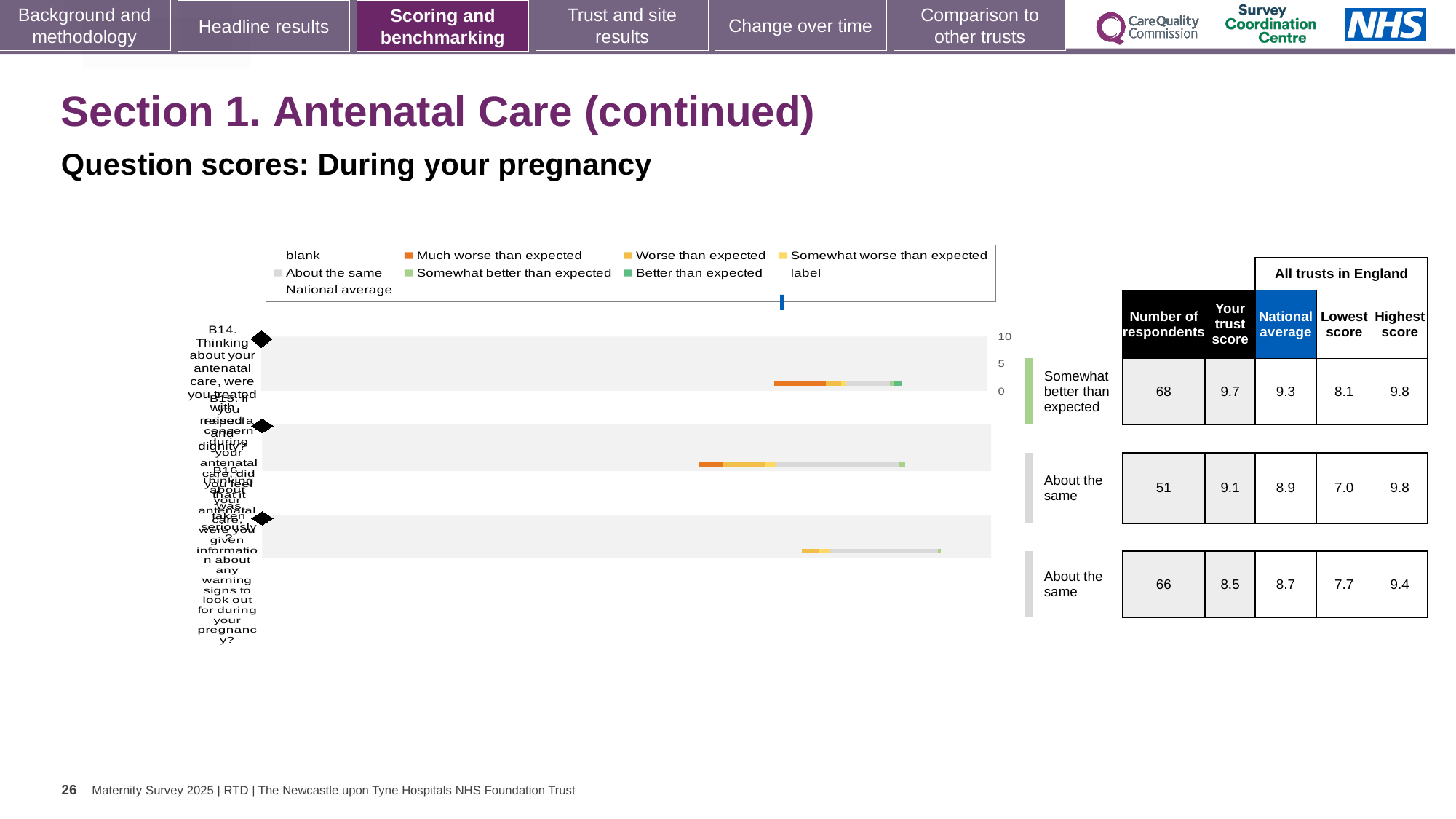
What kind of chart is shown on the slide? bar chart In the table beside the chart, what is the number of respondents for the first row (B14)? 68 How many question bars are plotted in the chart? 3 For the first row (B14), what is the difference between the trust score and the national average? 0.4 Which row in the table has the lowest 'Lowest score' value? the second row, 7.0 What colour does the legend use for 'Much worse than expected'? orange What is the highest tick value shown on the chart's score axis? 10 For the first row (B14), which is larger: the trust score or the national average? the trust score In the table beside the chart, what is 'Your trust score' for the first row (B14)? 9.7 In the table beside the chart, what is the national average for the first row (B14)? 9.3 What benchmark category is given for the first row (B14)? Somewhat better than expected Which row in the table has the highest 'Your trust score'? the first row (B14), 9.7